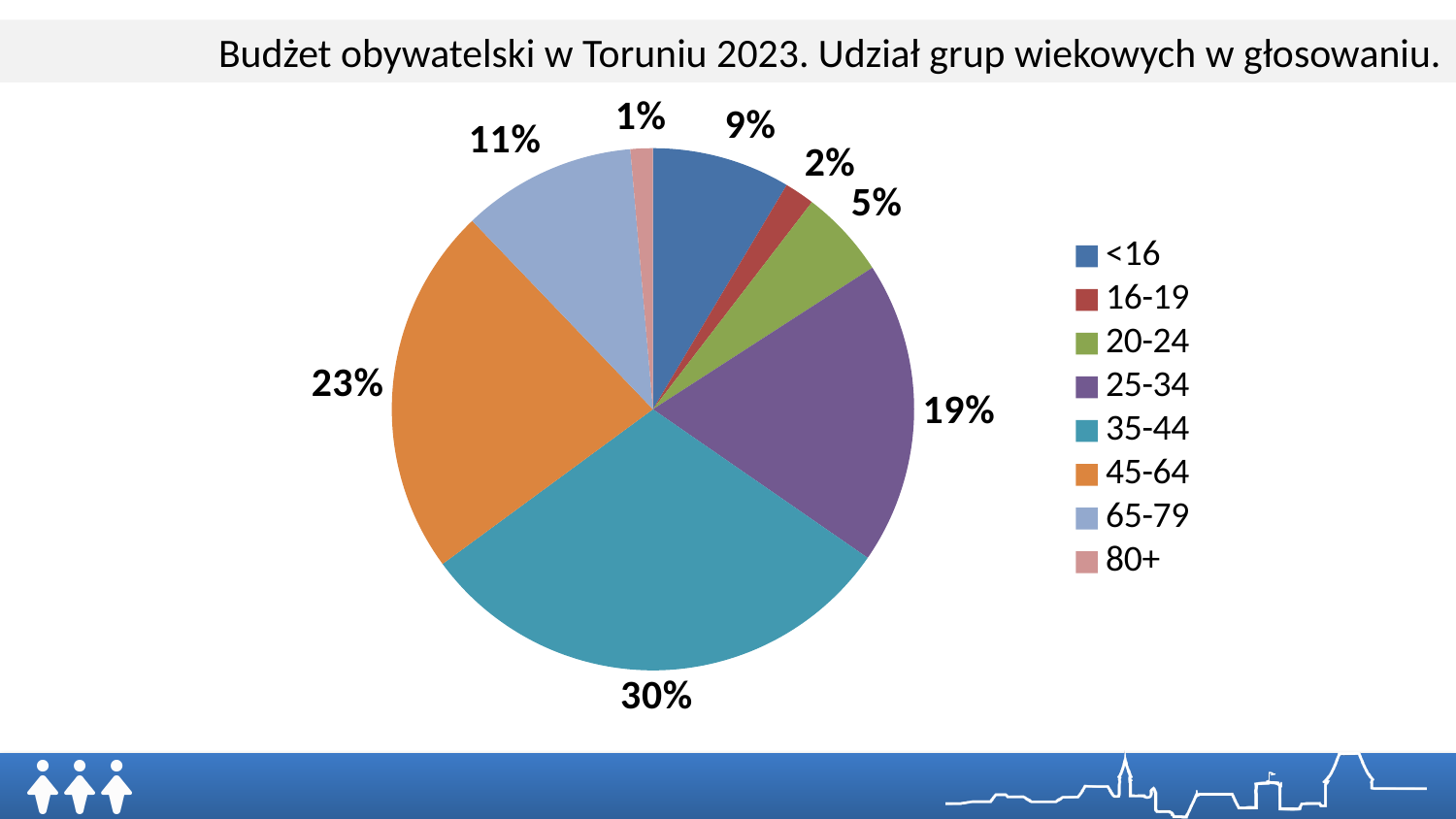
Which age group has the smallest share of the vote? 80+ Which age group has the largest share of the vote? 35-44 What share of the vote does the 65-79 age group have? 11% What is the difference in percentage points between the 35-44 and 25-34 age groups? 11 How many age groups are shown in the pie chart? 8 What colour is the slice for the 45-64 age group? orange What kind of chart is shown on the slide? pie chart What share of the vote does the <16 age group have? 9% Which has a larger share, the 20-24 group or the 16-19 group? 20-24 What share of the vote does the 35-44 age group have? 30% What share of the vote does the 45-64 age group have? 23% What is the combined share of the 45-64 and 65-79 age groups? 34%